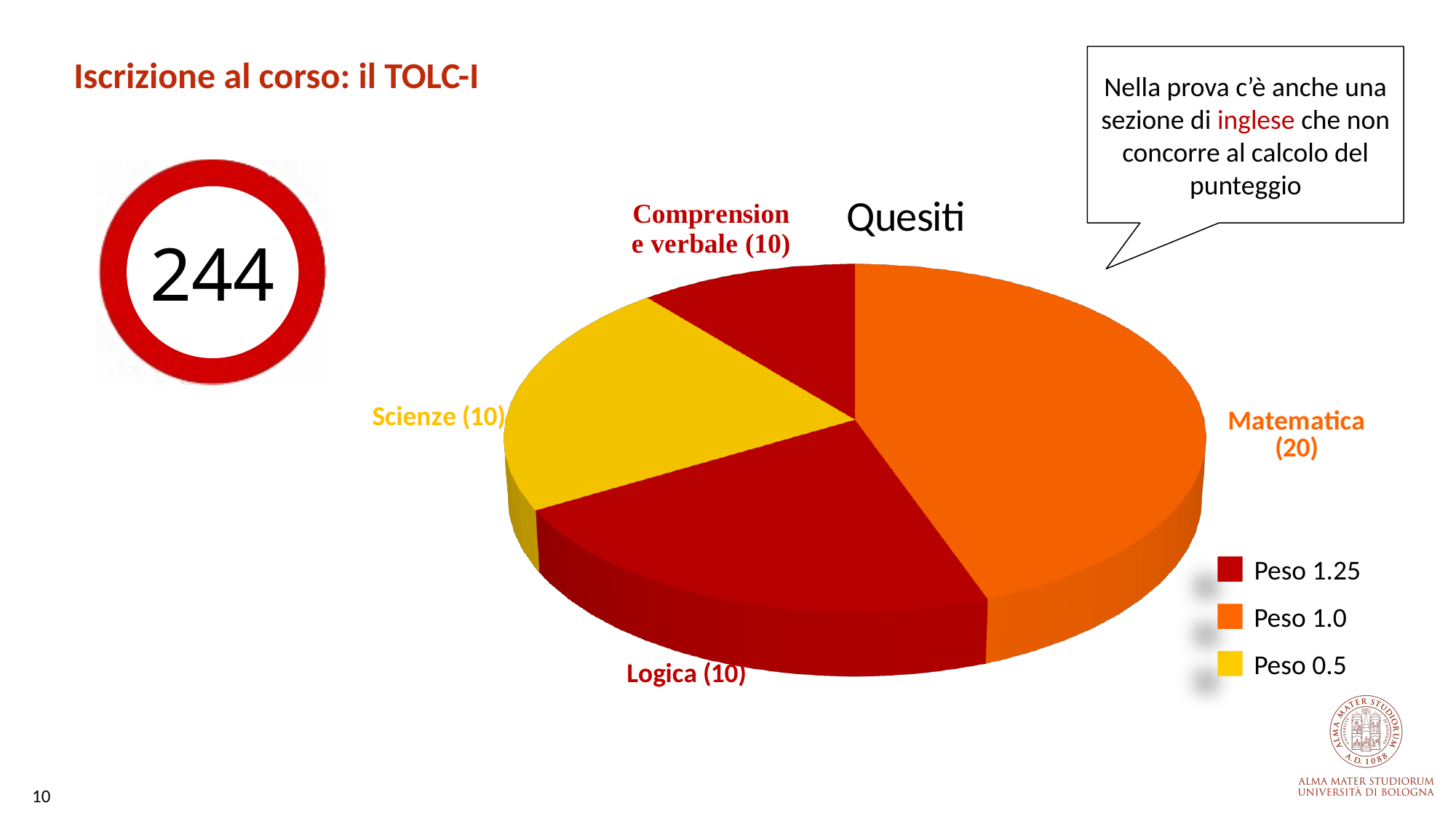
How many entries does the legend of the pie chart list? 3 What kind of chart is shown on the slide? pie chart How many questions does the Matematica slice represent? 20 How many questions does the Logica slice represent? 10 What is the difference between the number of questions for Matematica and for Scienze? 10 Which category has the largest slice in the pie chart? Matematica Which is larger, the Matematica slice or the Comprensione verbale slice? Matematica Which legend entry corresponds to the yellow slice (Scienze)? Peso 0.5 How many slices does the pie chart have? 4 What is the title of the pie chart? Quesiti